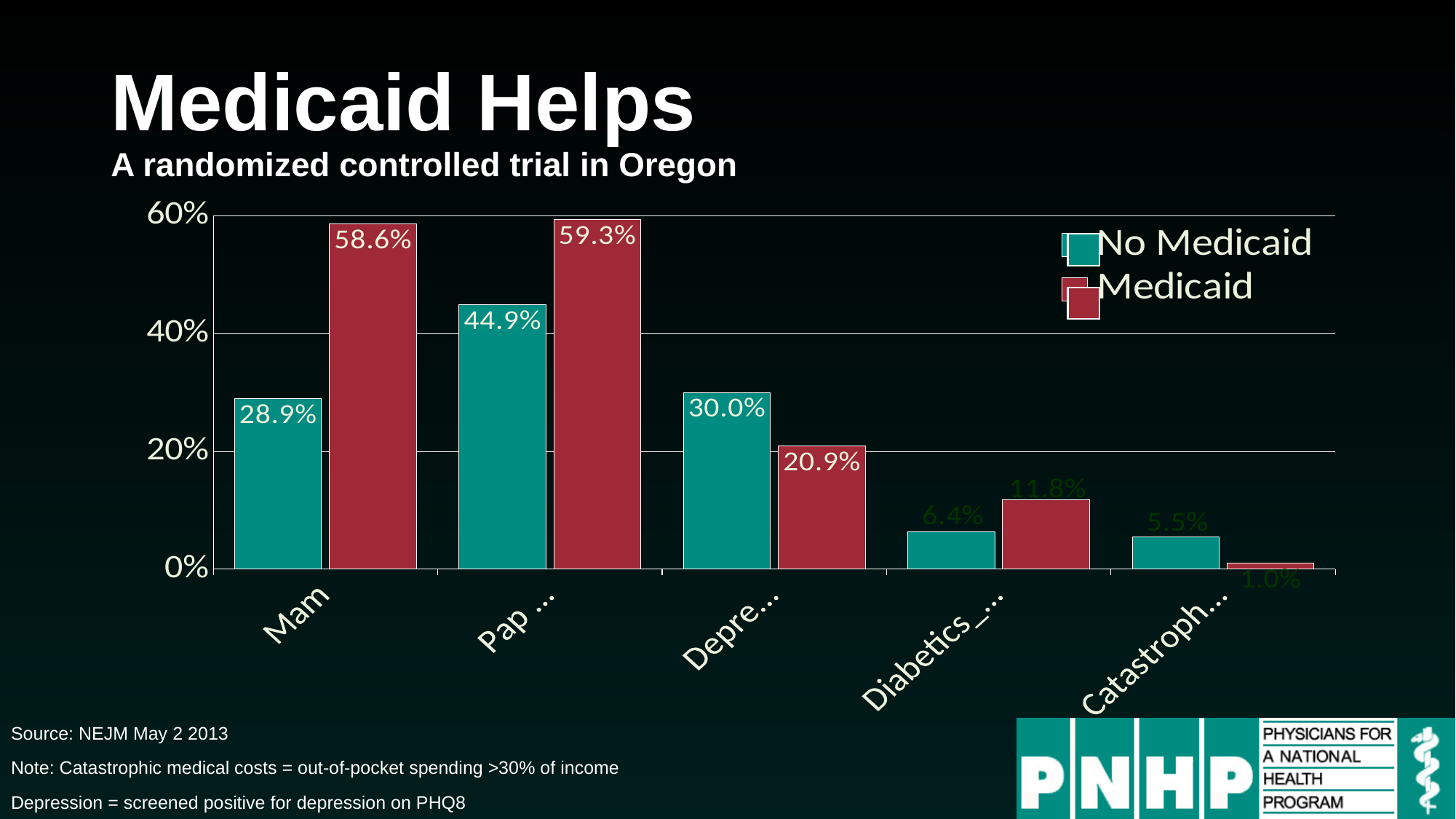
Which category has the highest Medicaid value? Pap ... What is the Medicaid value for the first category (labelled "Mam")? 58.6% How many series does the legend list? 2 What is the No Medicaid value for the first category (labelled "Mam")? 28.9% Which category has the lowest Medicaid value? Catastroph... How many categories are shown along the x axis? 5 What is the No Medicaid value for the second category (labelled "Pap ...")? 44.9% What kind of chart is shown on the slide? bar chart What is the difference between the Medicaid and No Medicaid values for the first category (labelled "Mam")? 29.7% What is the Medicaid value for the third category (labelled "Depre...")? 20.9% What are the two series named in the legend? No Medicaid and Medicaid For the third category (labelled "Depre..."), which is larger: the No Medicaid value or the Medicaid value? No Medicaid